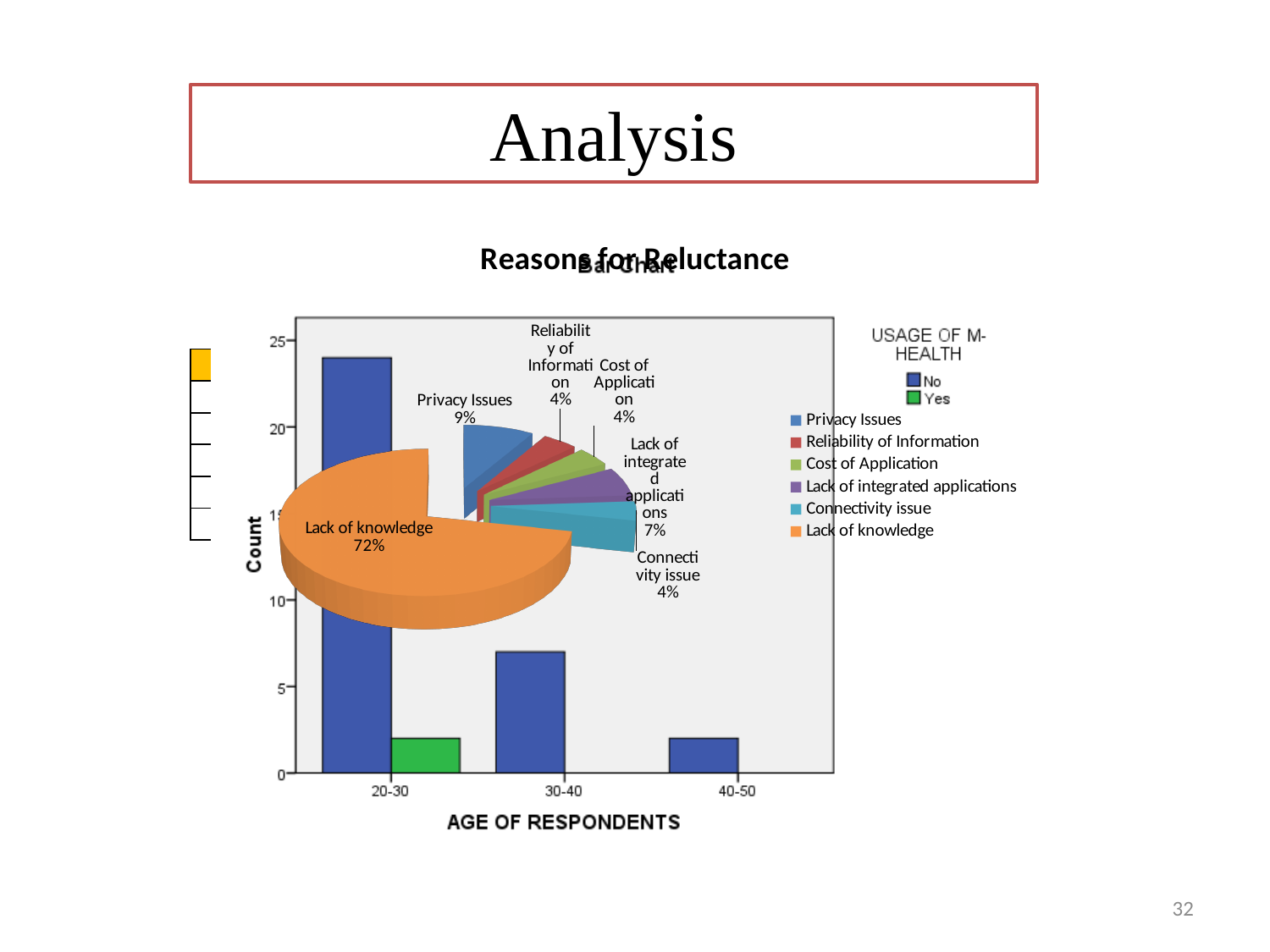
What kind of chart is the Reasons for Reluctance chart? Pie chart In the Reasons for Reluctance pie chart, what share is labelled for Lack of knowledge? 72% In the Reasons for Reluctance pie chart, what percentage is shown for Privacy Issues? 9% In the bar chart of AGE OF RESPONDENTS, how many age groups are shown on the x axis? 3 How many slices does the Reasons for Reluctance pie chart have? 6 In the bar chart of AGE OF RESPONDENTS, is the count for No in the 30-40 group greater or less than 10? less In the Reasons for Reluctance pie chart, how many percentage points larger is Privacy Issues than Lack of integrated applications? 2 percentage points In the bar chart of AGE OF RESPONDENTS, which age group has the higher count for No: 20-30 or 30-40? 20-30 In the Reasons for Reluctance pie chart, which reason has the largest slice? Lack of knowledge In the bar chart of AGE OF RESPONDENTS, how many series does the USAGE OF M-HEALTH legend list? 2 In the bar chart of AGE OF RESPONDENTS, is the count for No in the 20-30 group greater or less than 20? greater In the Reasons for Reluctance pie chart, what percentage is shown for Lack of integrated applications? 7%